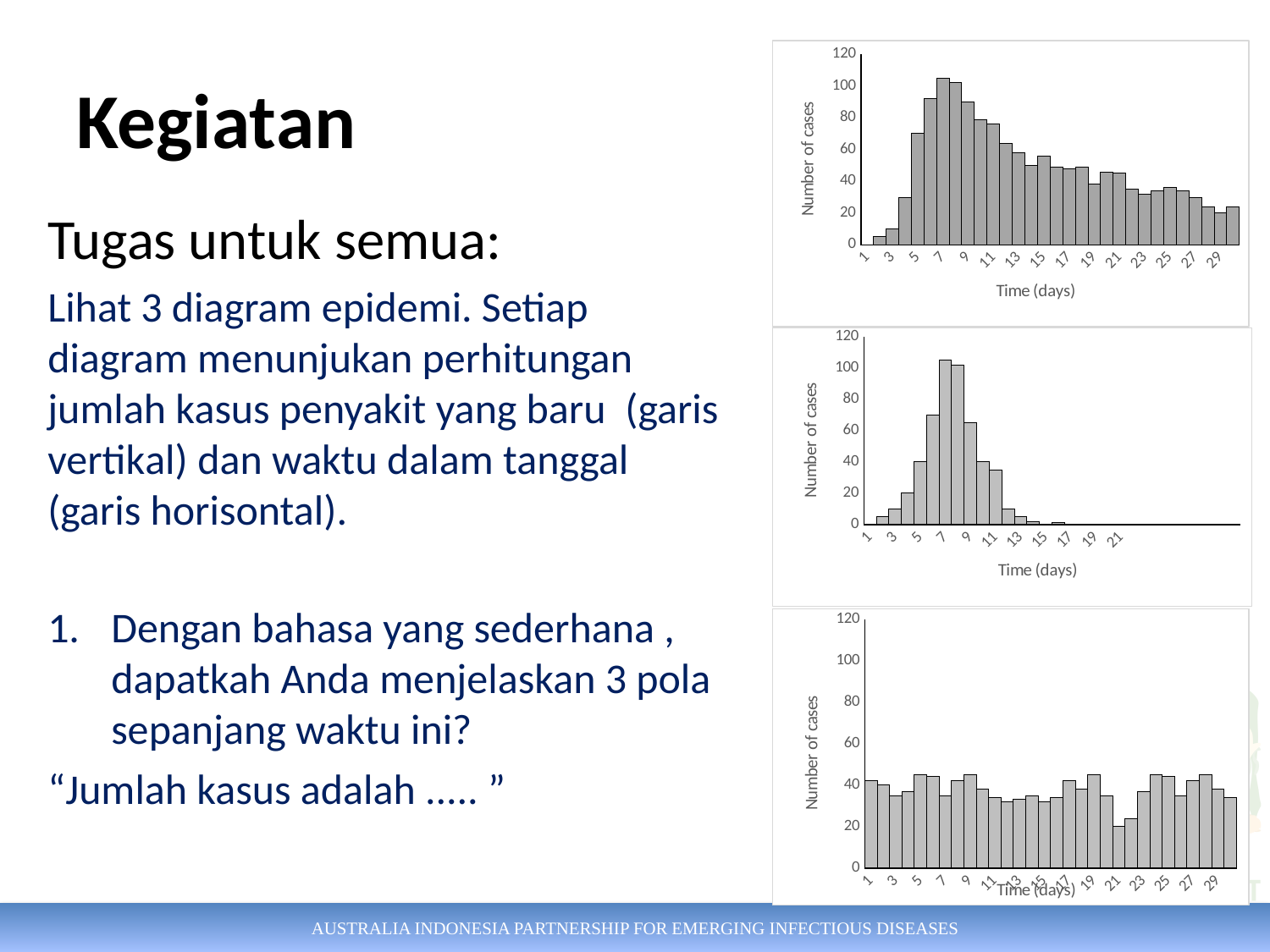
In the middle chart, is the value for day 13 greater or less than 20? less In the bottom chart, is the value for day 1 greater or less than 20? greater How many charts are shown on the slide? 3 What is the label of the horizontal axis on the middle chart? Time (days) In the middle chart, is the value for day 7 greater or less than 80? greater What is the label of the vertical axis on the top chart? Number of cases In the top chart, which is larger, the value for day 7 or the value for day 29? day 7 In the middle chart, do the values rise or fall from day 9 to day 17? fall What kind of chart is the top chart on the right side of the slide? bar chart